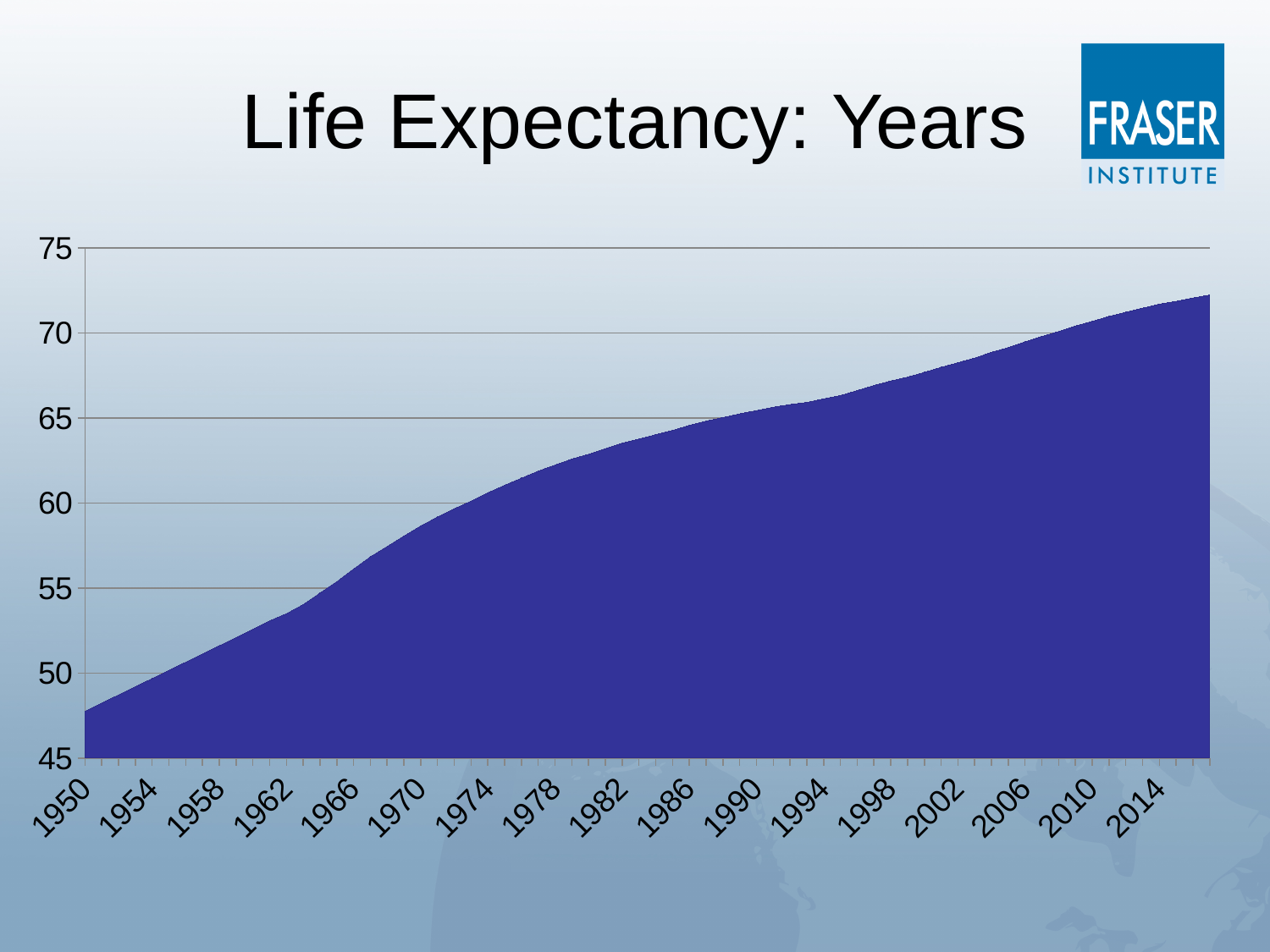
Is the value for 2014 greater or less than 70? greater Which year has the lowest life expectancy? 1950 Is the value for 2002 greater or less than 70? less What kind of chart is shown on the slide? area chart Is the value for 1950 greater or less than 50? less What is the highest value shown on the vertical axis? 75 Do the values rise or fall from 1950 to 2014? rise What is the title of the chart? Life Expectancy: Years Which is larger, the value for 1966 or the value for 1986? 1986